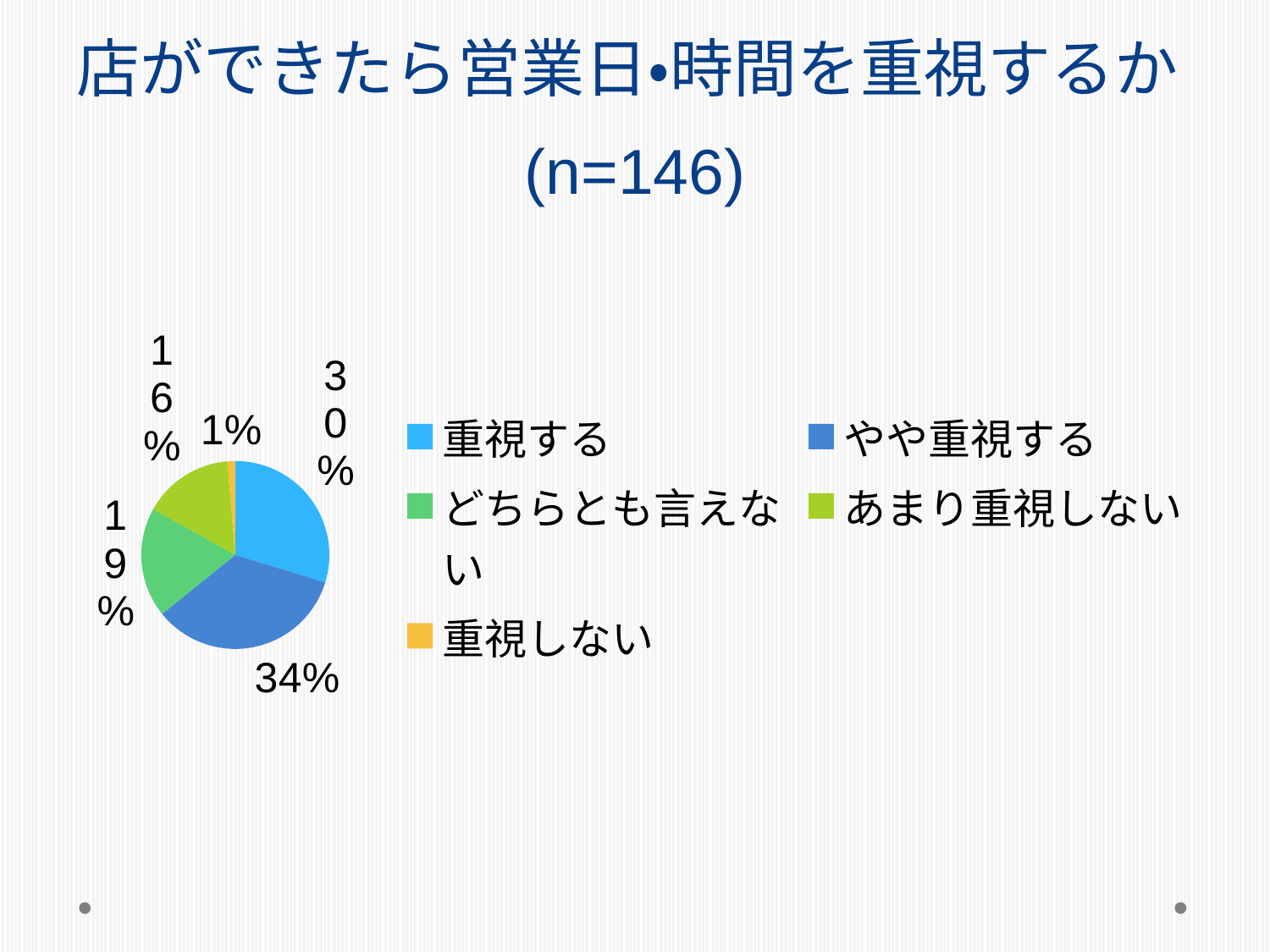
Which category has the largest slice of the pie chart? やや重視する How many categories does the legend of the pie chart list? 5 What percentage of the pie chart is labelled for どちらとも言えない? 19% Which is larger, the slice for どちらとも言えない or the slice for あまり重視しない? どちらとも言えない Which category has the smallest slice of the pie chart? 重視しない What percentage of the pie chart is labelled for 重視する? 30% What is the sample size (n) given in the chart title? 146 What percentage of the pie chart is labelled for やや重視する? 34% What percentage of the pie chart is labelled for あまり重視しない? 16% What is the difference in percentage points between やや重視する and 重視する? 4 What kind of chart is shown on the slide? pie chart What percentage of the pie chart is labelled for 重視しない? 1%